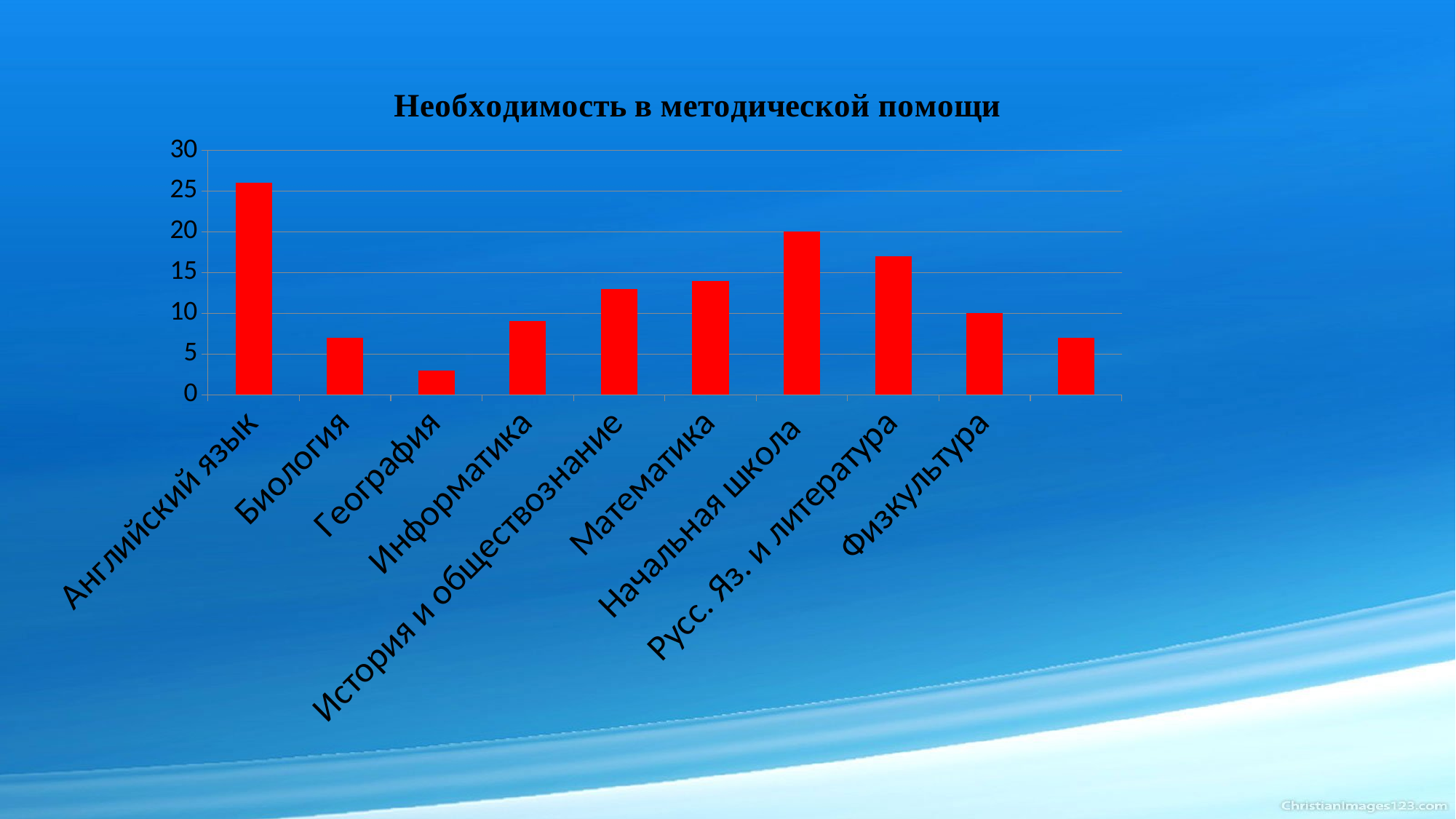
Which is larger, the value for Математика or the value for Биология? Математика Which category has the highest bar? Английский язык Is the value for История и обществознание greater or less than 10? greater What kind of chart is shown on the slide? bar chart What is the value for Начальная школа? 20 Is the value for Биология greater or less than 10? less Is the value for Английский язык greater or less than 25? greater Which category has the lowest bar? География What is the value for Физкультура? 10 What is the title of the chart? Необходимость в методической помощи What colour are the bars in the chart? red